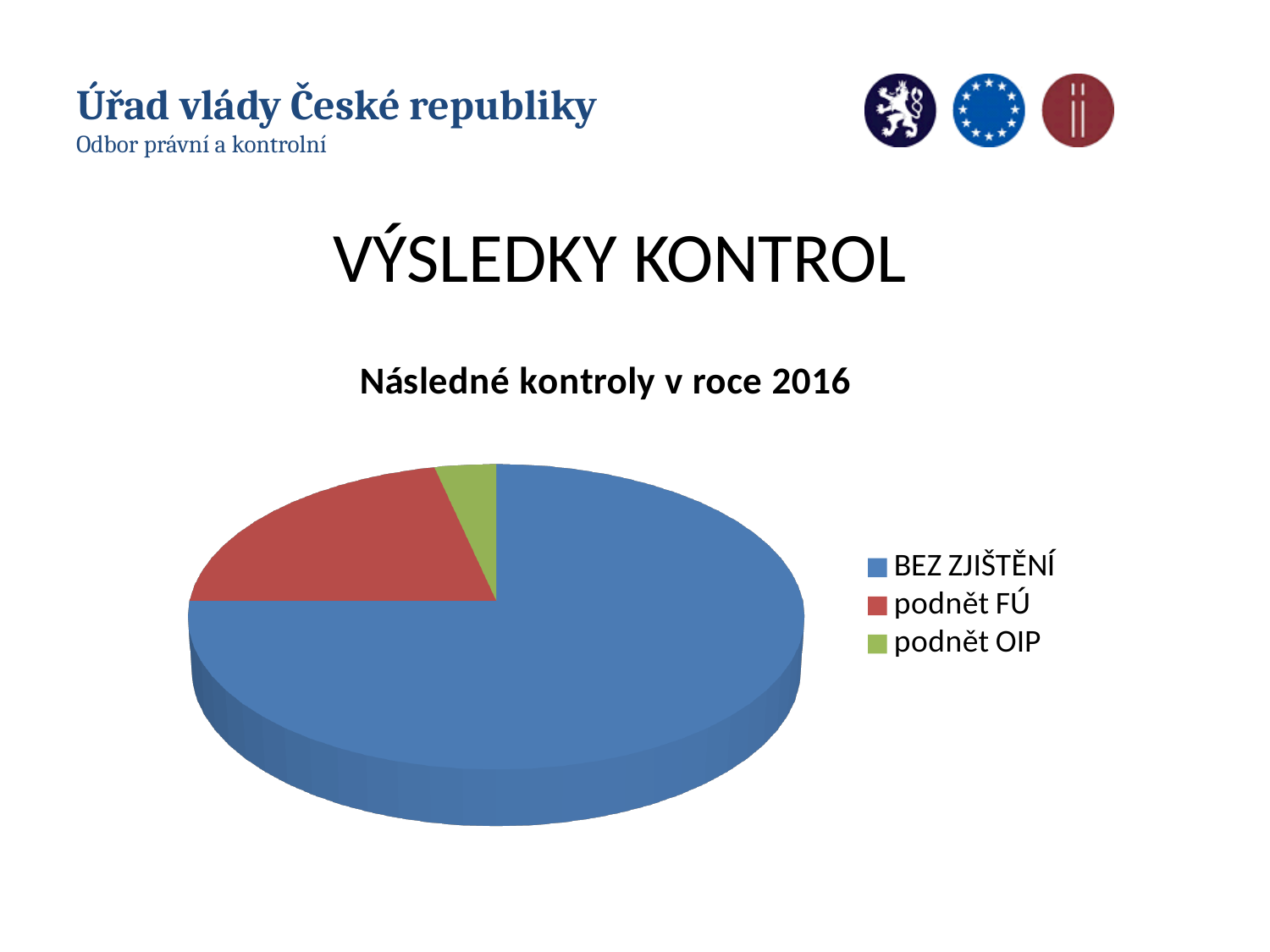
Which slice is larger, BEZ ZJIŠTĚNÍ or podnět FÚ? BEZ ZJIŠTĚNÍ How many slices does the pie chart have? 3 What colour is the slice for podnět FÚ? red What is the title of the chart? Následné kontroly v roce 2016 Which category has the smallest slice of the pie? podnět OIP Does the BEZ ZJIŠTĚNÍ slice take up more or less than half of the pie? more How many entries does the legend list? 3 What kind of chart is shown on the slide? pie chart Which slice is larger, podnět FÚ or podnět OIP? podnět FÚ Which category has the largest slice of the pie? BEZ ZJIŠTĚNÍ